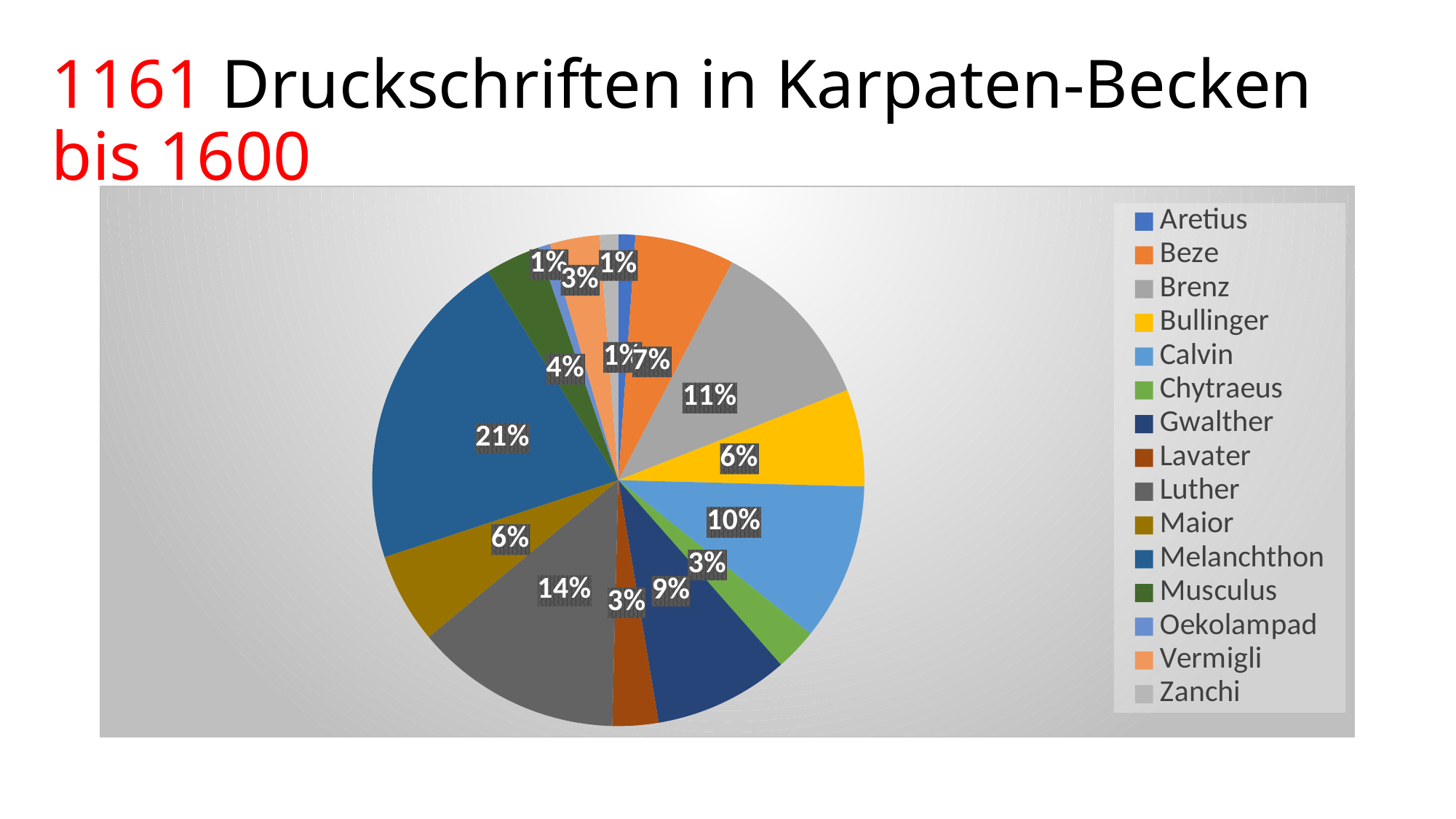
What kind of chart is shown on the slide? pie chart What share of the pie does Gwalther have? 9% What share of the pie does Brenz have? 11% What share of the pie does Musculus have? 4% Which author has the largest slice of the pie? Melanchthon How many entries does the legend of the pie chart list? 15 What is the difference in percentage points between the Melanchthon slice and the Luther slice? 7 What is the title of the slide containing the pie chart? 1161 Druckschriften in Karpaten-Becken bis 1600 Which is larger, the slice for Beze or the slice for Bullinger? Beze